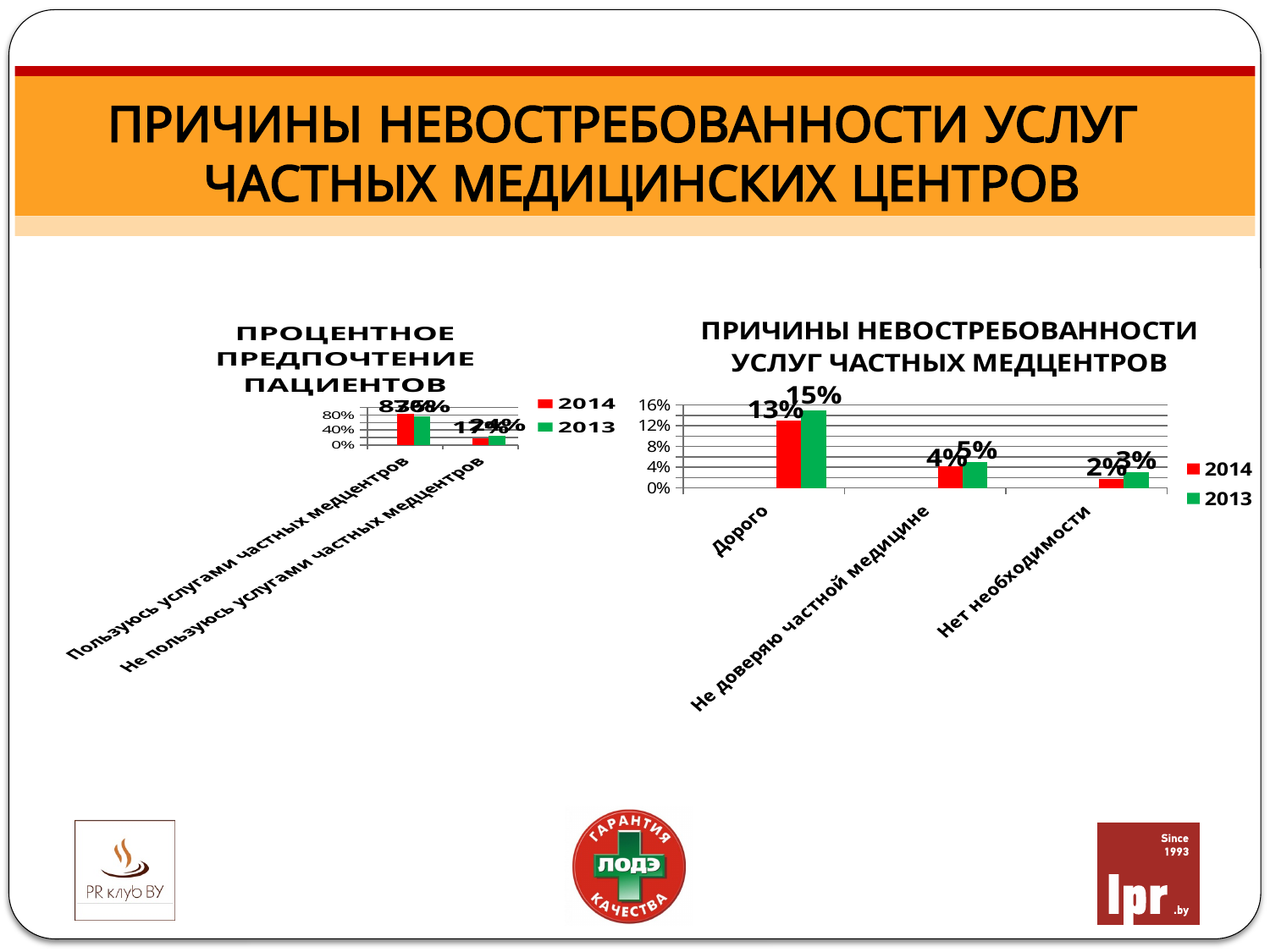
In the chart titled "ПРИЧИНЫ НЕВОСТРЕБОВАННОСТИ УСЛУГ ЧАСТНЫХ МЕДЦЕНТРОВ", what is the 2013 value for "Не доверяю частной медицине"? 5% In the chart titled "ПРИЧИНЫ НЕВОСТРЕБОВАННОСТИ УСЛУГ ЧАСТНЫХ МЕДЦЕНТРОВ", which is larger for "Не доверяю частной медицине": the 2014 value or the 2013 value? 2013 In the chart titled "ПРИЧИНЫ НЕВОСТРЕБОВАННОСТИ УСЛУГ ЧАСТНЫХ МЕДЦЕНТРОВ", what is the 2014 value for "Нет необходимости"? 2% In the chart titled "ПРОЦЕНТНОЕ ПРЕДПОЧТЕНИЕ ПАЦИЕНТОВ", is the 2014 value for "Пользуюсь услугами частных медцентров" greater or less than 40%? greater In the chart titled "ПРИЧИНЫ НЕВОСТРЕБОВАННОСТИ УСЛУГ ЧАСТНЫХ МЕДЦЕНТРОВ", which category has the highest 2013 value? Дорого In the chart titled "ПРИЧИНЫ НЕВОСТРЕБОВАННОСТИ УСЛУГ ЧАСТНЫХ МЕДЦЕНТРОВ", what is the difference between the 2013 and 2014 values for "Дорого"? 2% How many categories are shown in the chart titled "ПРИЧИНЫ НЕВОСТРЕБОВАННОСТИ УСЛУГ ЧАСТНЫХ МЕДЦЕНТРОВ"? 3 In the chart titled "ПРИЧИНЫ НЕВОСТРЕБОВАННОСТИ УСЛУГ ЧАСТНЫХ МЕДЦЕНТРОВ", what is the 2014 value for "Дорого"? 13% In the chart titled "ПРИЧИНЫ НЕВОСТРЕБОВАННОСТИ УСЛУГ ЧАСТНЫХ МЕДЦЕНТРОВ", what is the 2013 value for "Дорого"? 15% How many series does the legend list in the chart titled "ПРОЦЕНТНОЕ ПРЕДПОЧТЕНИЕ ПАЦИЕНТОВ"? 2 In the chart titled "ПРИЧИНЫ НЕВОСТРЕБОВАННОСТИ УСЛУГ ЧАСТНЫХ МЕДЦЕНТРОВ", which category has the lowest 2014 value? Нет необходимости What kind of chart is the one titled "ПРОЦЕНТНОЕ ПРЕДПОЧТЕНИЕ ПАЦИЕНТОВ"? bar chart